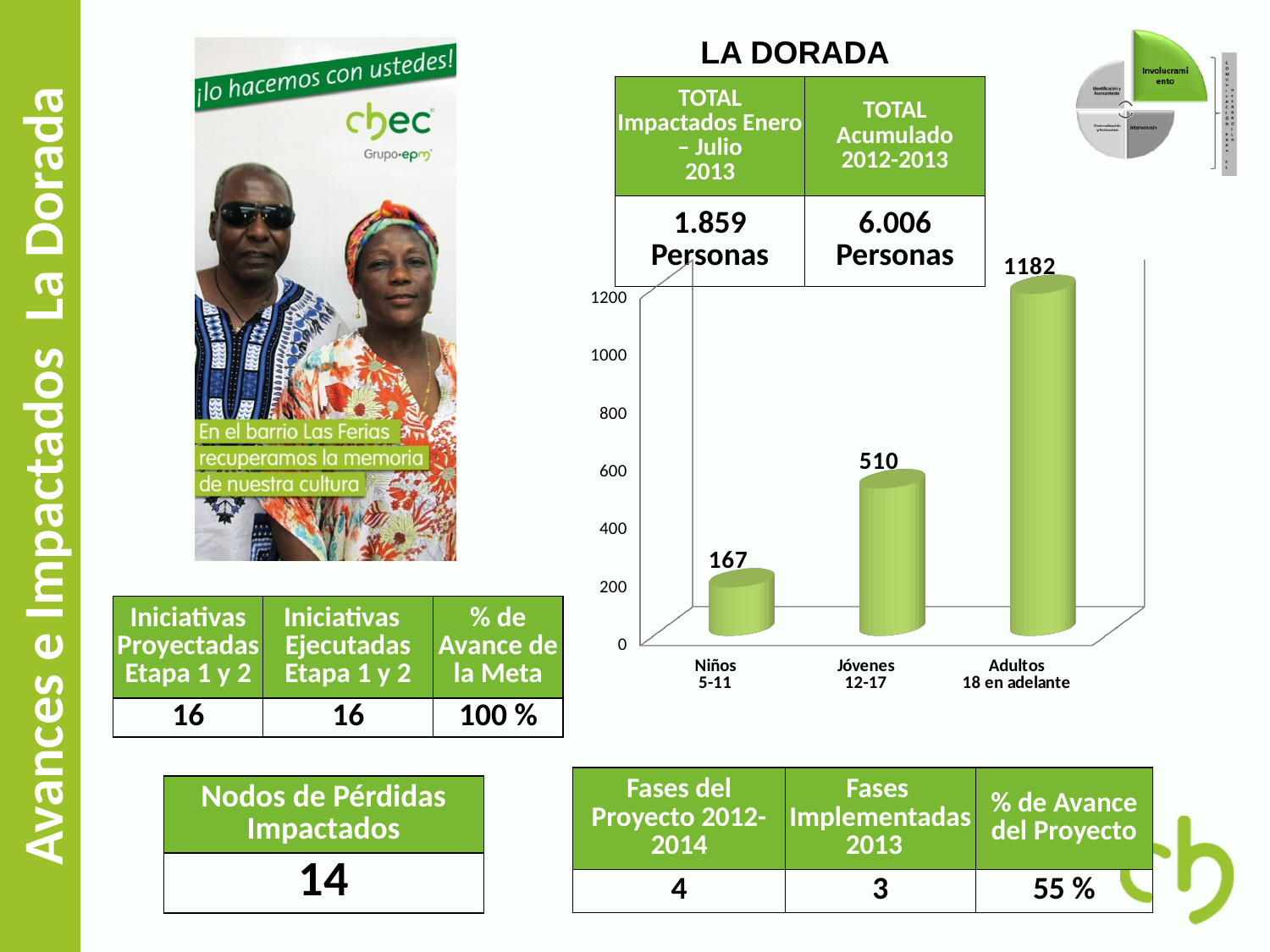
Which is larger, the value for Jóvenes 12-17 or the value for Niños 5-11? Jóvenes 12-17 What is the value for Jóvenes 12-17 in the bar chart? 510 Is the value for Adultos 18 en adelante greater or less than 1000? greater Which category has the highest value in the bar chart? Adultos 18 en adelante What is the difference between the values for Adultos 18 en adelante and Jóvenes 12-17? 672 Do the values rise or fall from Niños 5-11 to Adultos 18 en adelante along the x axis? rise Which category has the lowest value in the bar chart? Niños 5-11 How many categories are shown in the bar chart? 3 What is the value for Adultos 18 en adelante in the bar chart? 1182 What is the difference between the values for Jóvenes 12-17 and Niños 5-11? 343 What is the value for Niños 5-11 in the bar chart? 167 What kind of chart is shown on the slide? bar chart